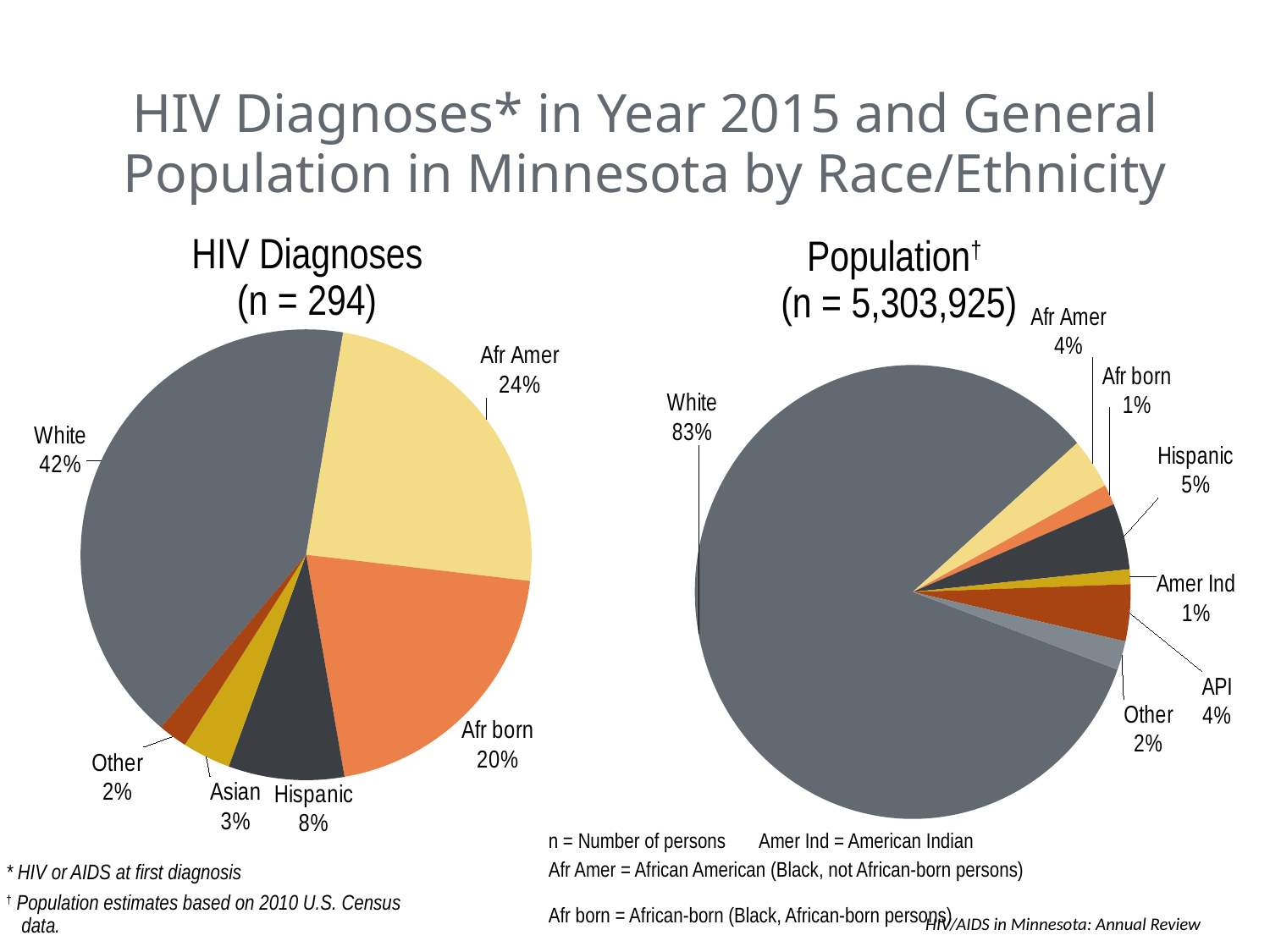
What is the difference between the White share in the Population pie chart and the White share in the HIV Diagnoses pie chart? 41% What kind of charts are shown on the slide? Pie charts What is the n value shown for the Population pie chart? 5,303,925 In the Population pie chart, what share is API? 4% In the HIV Diagnoses pie chart, which labeled group has the largest share? White In the HIV Diagnoses pie chart, what share of diagnoses is White? 42% In the Population pie chart, which group has the largest share? White In the Population pie chart, what share is Hispanic? 5% In the HIV Diagnoses pie chart, which is larger, the Afr Amer share or the Afr born share? Afr Amer How many labeled slices does the Population pie chart have? 7 In the HIV Diagnoses pie chart, what share is Afr born? 20% In the HIV Diagnoses pie chart, what is the difference between the Afr Amer share and the Hispanic share? 16%